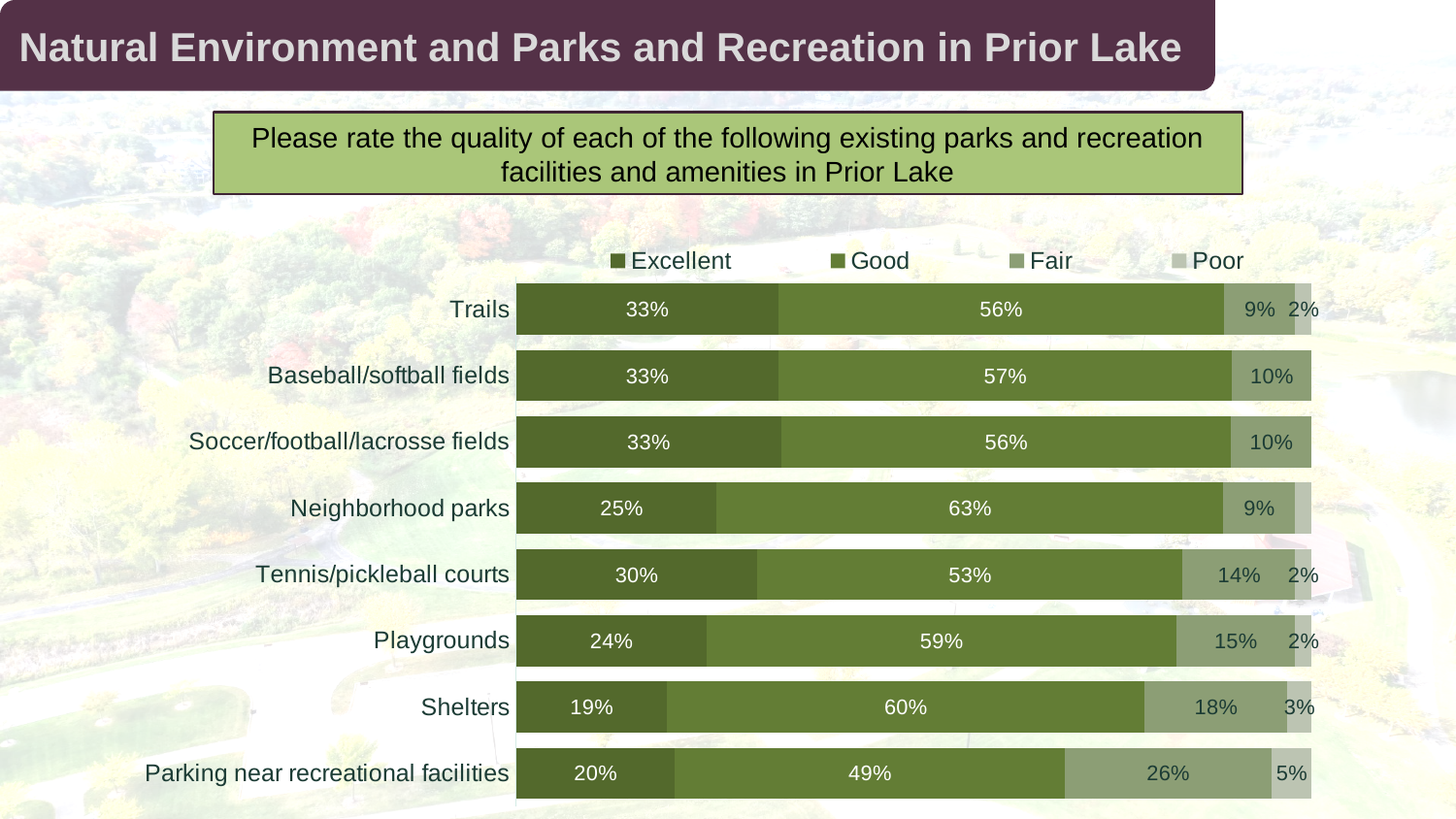
What percentage rated Trails as Good? 56% What is the difference in percentage points between the Good rating for Neighborhood parks and the Good rating for Parking near recreational facilities? 14 What percentage rated Shelters as Poor? 3% What kind of chart is shown on the slide? Stacked bar chart How many rating categories does the legend list? 4 Which facility has the lowest Excellent rating? Shelters Which has a larger Fair rating, Parking near recreational facilities or Shelters? Parking near recreational facilities How many facilities are rated in the chart? 8 Which facility has the highest Good rating? Neighborhood parks What percentage rated Neighborhood parks as Excellent? 25% What is the total of the four labelled segments for Trails? 100% What percentage rated Parking near recreational facilities as Fair? 26%